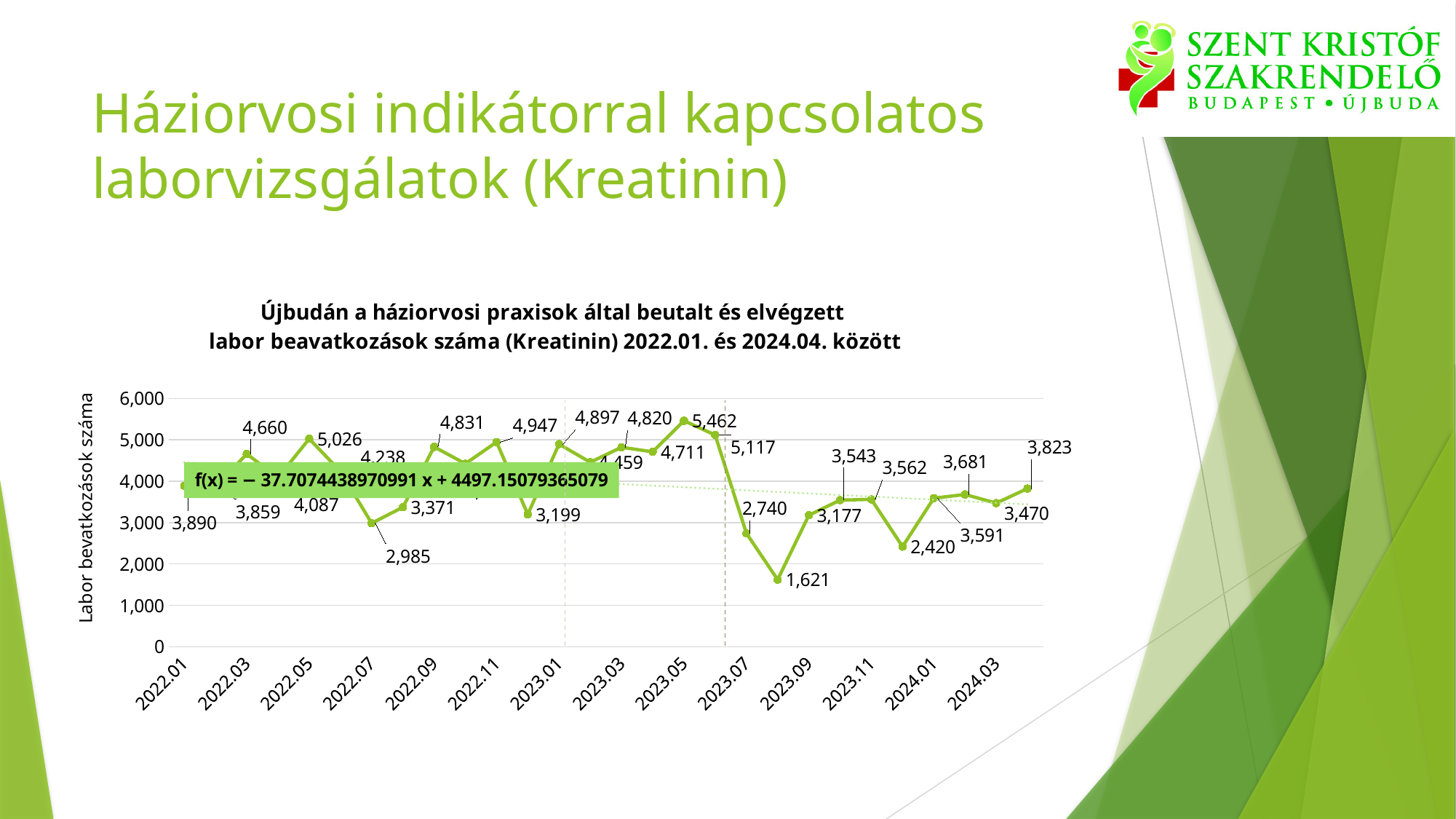
What is the value for 2022.07? 2,985 What is the value for 2022.01? 3,890 According to the dotted trendline, do the values overall rise or fall from 2022.01 to 2024.04? fall Which is larger, the value for 2022.05 or the value for 2022.07? 2022.05 What is the difference between the highest value (2023.05) and the lowest value (2023.08)? 3,841 Is the value for 2023.12 greater or less than 3,000? less What is the label of the vertical axis? Labor bevatkozások száma Which month has the highest number of lab interventions? 2023.05 Which month has the lowest number of lab interventions? 2023.08 What is the value for 2024.04? 3,823 What is the value for 2023.08? 1,621 What kind of chart is shown on the slide? line chart